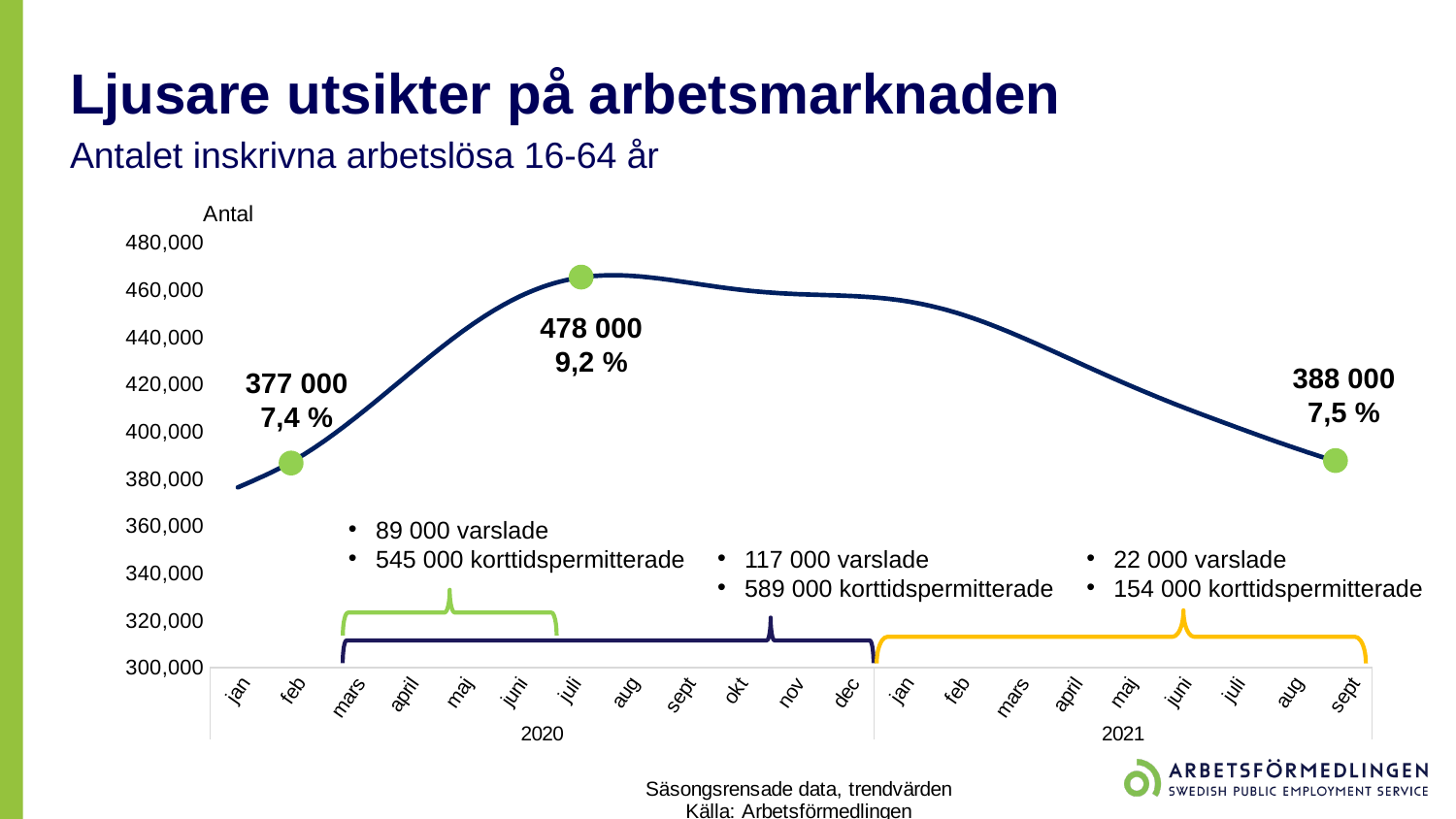
Is the value for December 2020 greater or less than 440,000? greater Is the value for January 2020 greater or less than 400,000? less Which of the three labelled points has the highest number of registered unemployed? juli 2020 Which is larger, the value for February 2020 or the value for September 2021? September 2021 What is the number of registered unemployed shown for July 2020? 478 000 What is the difference between the July 2020 value and the September 2021 value? 90 000 What is the number of registered unemployed shown for September 2021? 388 000 What is the number of registered unemployed shown for February 2020? 377 000 What kind of chart is shown on the slide? line chart Does the line rise or fall from July 2020 to September 2021? fall What is the difference between the July 2020 value and the February 2020 value? 101 000 What unemployment rate is printed next to the July 2020 data point? 9,2 %